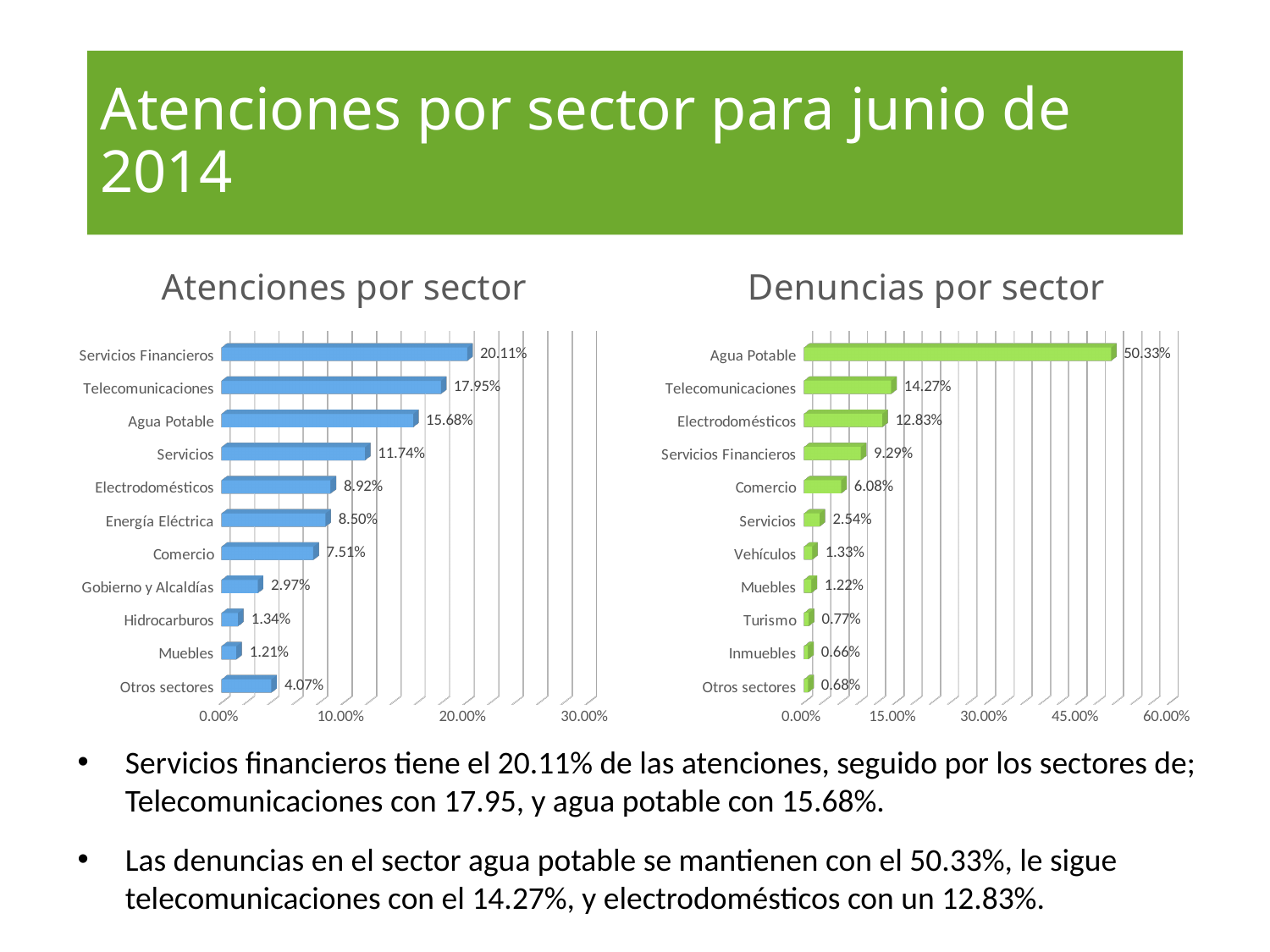
In the 'Denuncias por sector' chart, what is the difference between Agua Potable and Telecomunicaciones? 36.06% In the 'Atenciones por sector' chart, which category has the highest value? Servicios Financieros In the 'Atenciones por sector' chart, which is larger: Electrodomésticos or Comercio? Electrodomésticos In the 'Denuncias por sector' chart, what is the value for Agua Potable? 50.33% What colour are the bars in the 'Denuncias por sector' chart? Green In the 'Denuncias por sector' chart, which category has the lowest value? Inmuebles In the 'Denuncias por sector' chart, what is the value for Comercio? 6.08% In the 'Atenciones por sector' chart, what is the difference between Telecomunicaciones and Agua Potable? 2.27% What kind of chart is 'Atenciones por sector'? Bar chart In the 'Atenciones por sector' chart, what is the value for Servicios Financieros? 20.11% How many categories are shown in the 'Denuncias por sector' chart? 11 In the 'Atenciones por sector' chart, what is the value for Energía Eléctrica? 8.50%